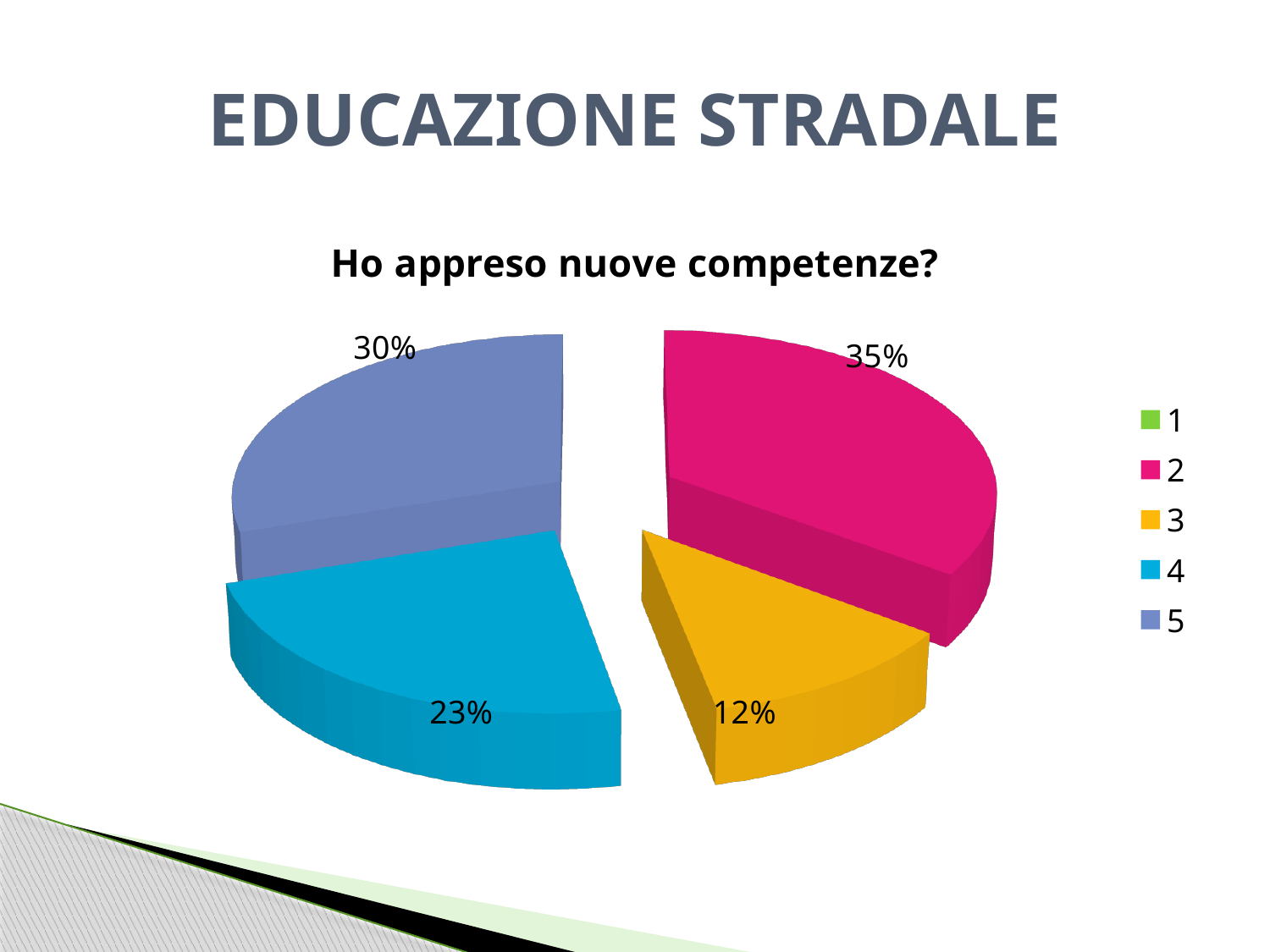
What percentage of the pie is category 5? 30% What kind of chart is shown on the slide? Pie chart What percentage of the pie is category 2? 35% What percentage of the pie is category 3? 12% What is the difference in percentage points between category 5 and category 4? 7% What percentage of the pie is category 4? 23% Which is larger, the slice for category 4 or the slice for category 5? 5 What is the title of the chart? Ho appreso nuove competenze? Which category has the largest slice of the pie? 2 What is the difference in percentage points between category 2 and category 3? 23% How many entries does the legend list? 5 Which category has the smallest visible slice of the pie? 3